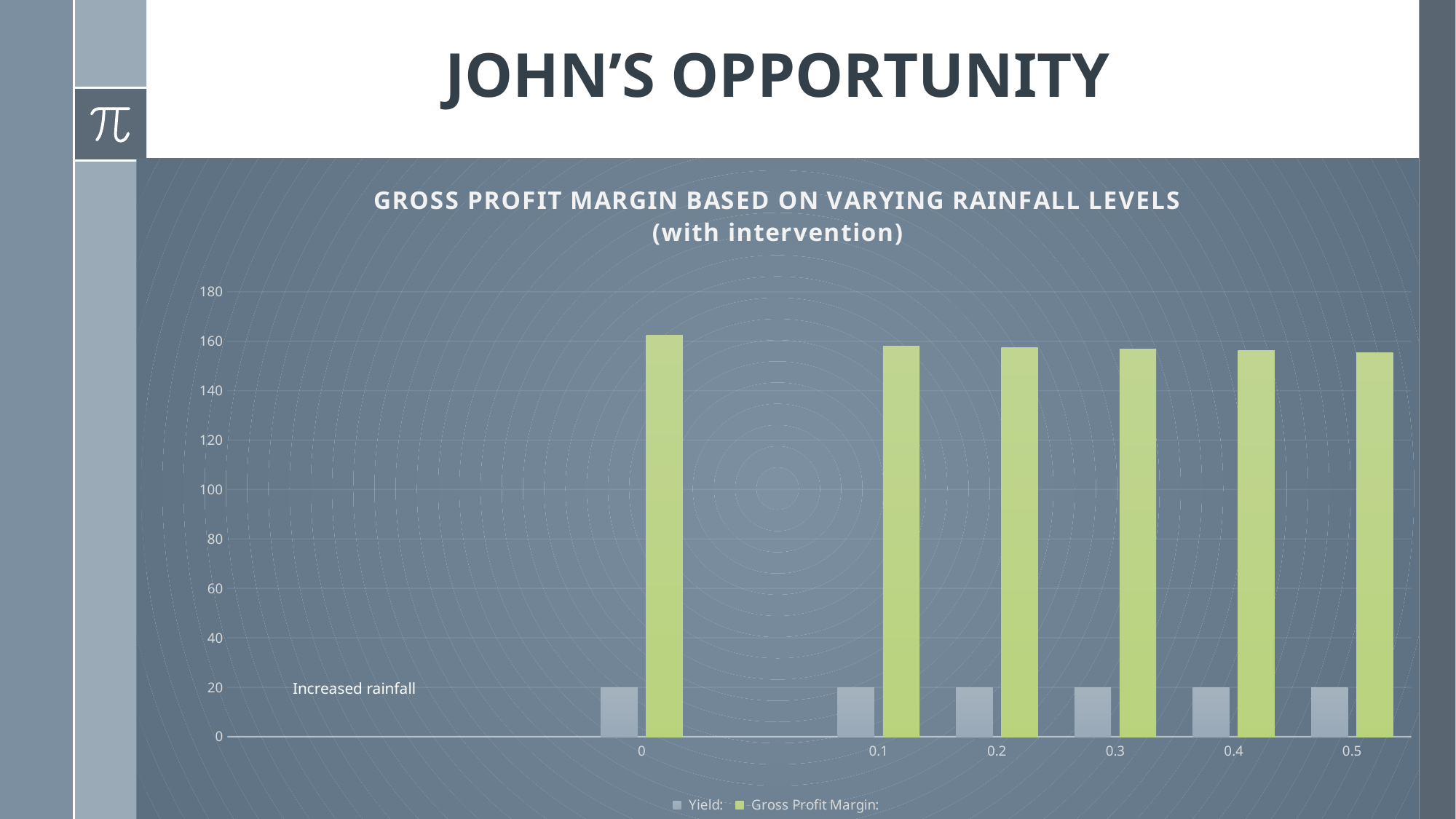
What is the title of the chart? GROSS PROFIT MARGIN BASED ON VARYING RAINFALL LEVELS (with intervention) Which is larger at rainfall level 0.2, Yield or Gross Profit Margin? Gross Profit Margin At which rainfall level is the Gross Profit Margin highest? 0 What is the Yield value at rainfall level 0? 20 Is the Gross Profit Margin at rainfall level 0.5 greater or less than 160? less Is the Gross Profit Margin at rainfall level 0 greater or less than 140? greater What is the Yield value at rainfall level 0.5? 20 Do the Gross Profit Margin values rise or fall as rainfall level increases from 0 to 0.5? fall What kind of chart is shown on the slide? bar chart How many categories are shown on the x axis? 6 Is the Gross Profit Margin at rainfall level 0.3 greater or less than 100? greater How many series does the legend list? 2